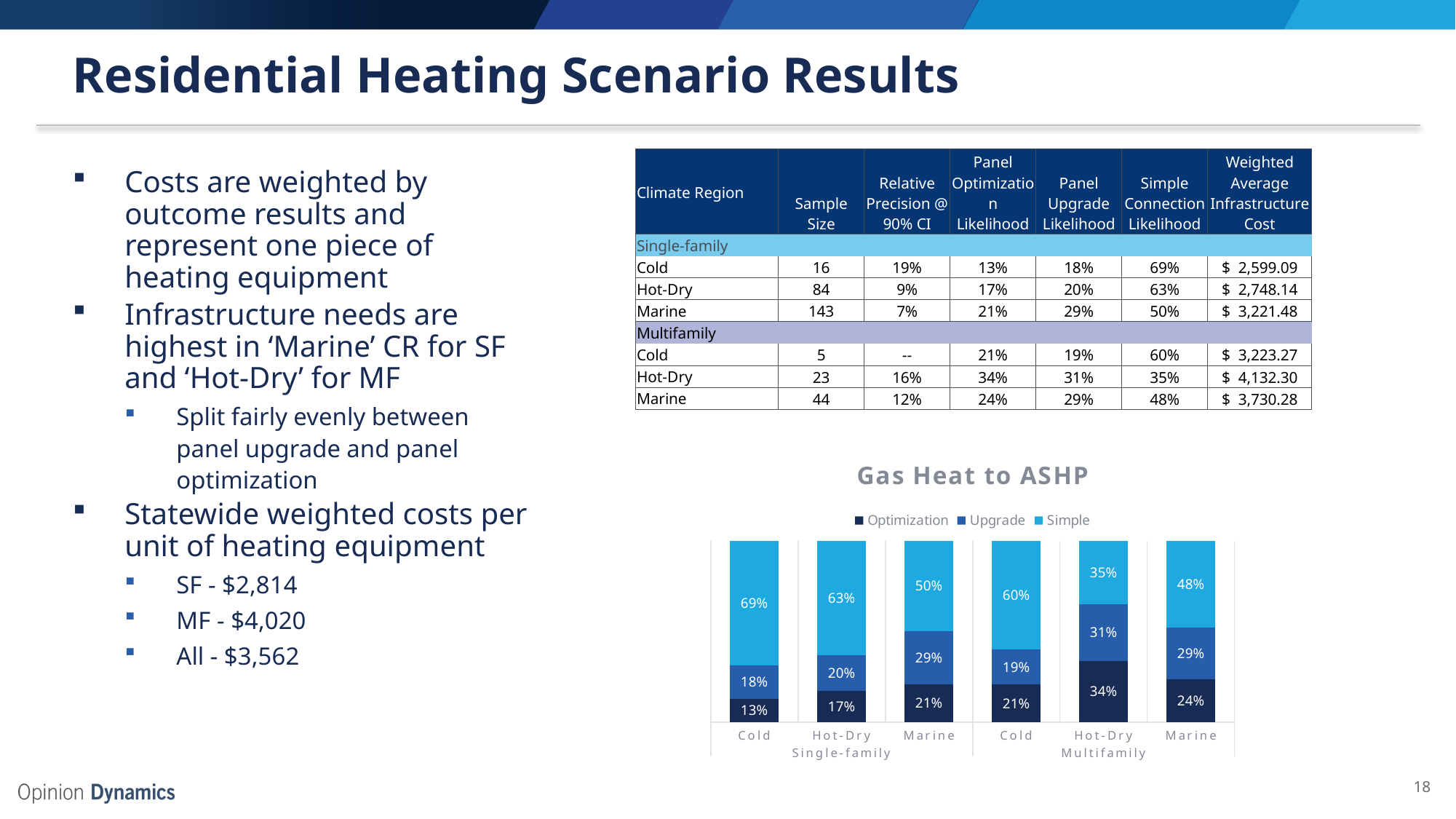
What is the difference between the Simple value for Cold in Single-family and the Simple value for Hot-Dry in Multifamily? 34% Which is larger: the Upgrade value for Hot-Dry in Multifamily or the Upgrade value for Hot-Dry in Single-family? Hot-Dry in Multifamily Which bar has the lowest Optimization value? Cold (Single-family) What is the Simple value for Cold in the Single-family group? 69% What type of chart is shown on the slide? Stacked bar chart What is the Optimization value for Hot-Dry in the Multifamily group? 34% How many series does the chart legend list? 3 What is the title of the chart? Gas Heat to ASHP Which bar has the highest Simple value? Cold (Single-family) What is the Upgrade value for Marine in the Single-family group? 29% What is the total of the stacked bar for Marine in the Multifamily group? 101% How many bars are plotted in the chart? 6